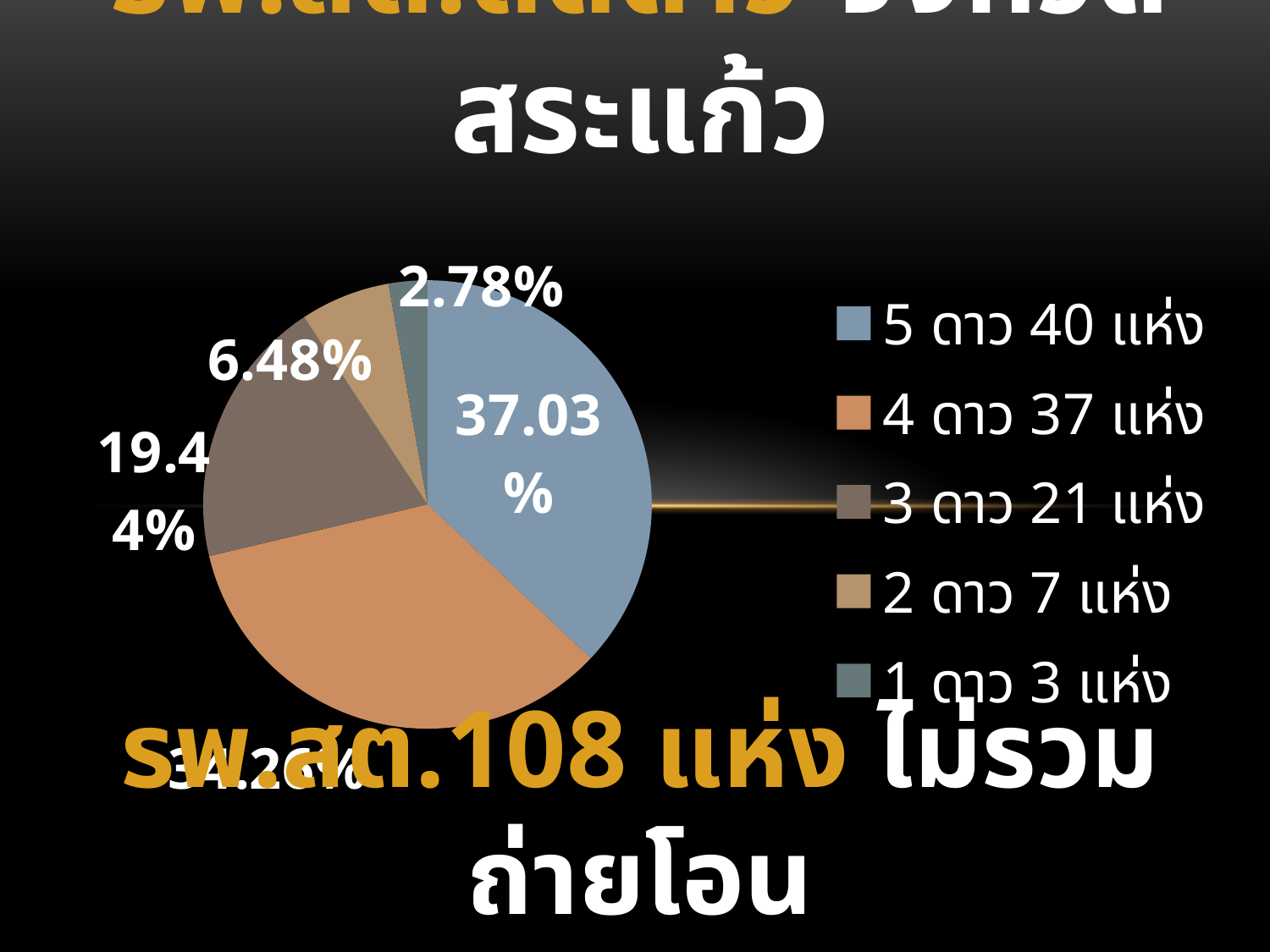
According to the legend, how many แห่ง are in the 4 ดาว category? 37 แห่ง Which category has the largest slice of the pie? 5 ดาว What kind of chart is shown on the slide? pie chart What share of the pie does the 3 ดาว slice represent? 19.44% What share of the pie does the 2 ดาว slice represent? 6.48% What is the difference in percentage points between the 5 ดาว slice and the 1 ดาว slice? 34.25% How many slices does the pie chart have? 5 How many entries does the legend list? 5 Which category has the smallest slice of the pie? 1 ดาว Which slice is larger, 3 ดาว or 2 ดาว? 3 ดาว What share of the pie does the 1 ดาว slice represent? 2.78%